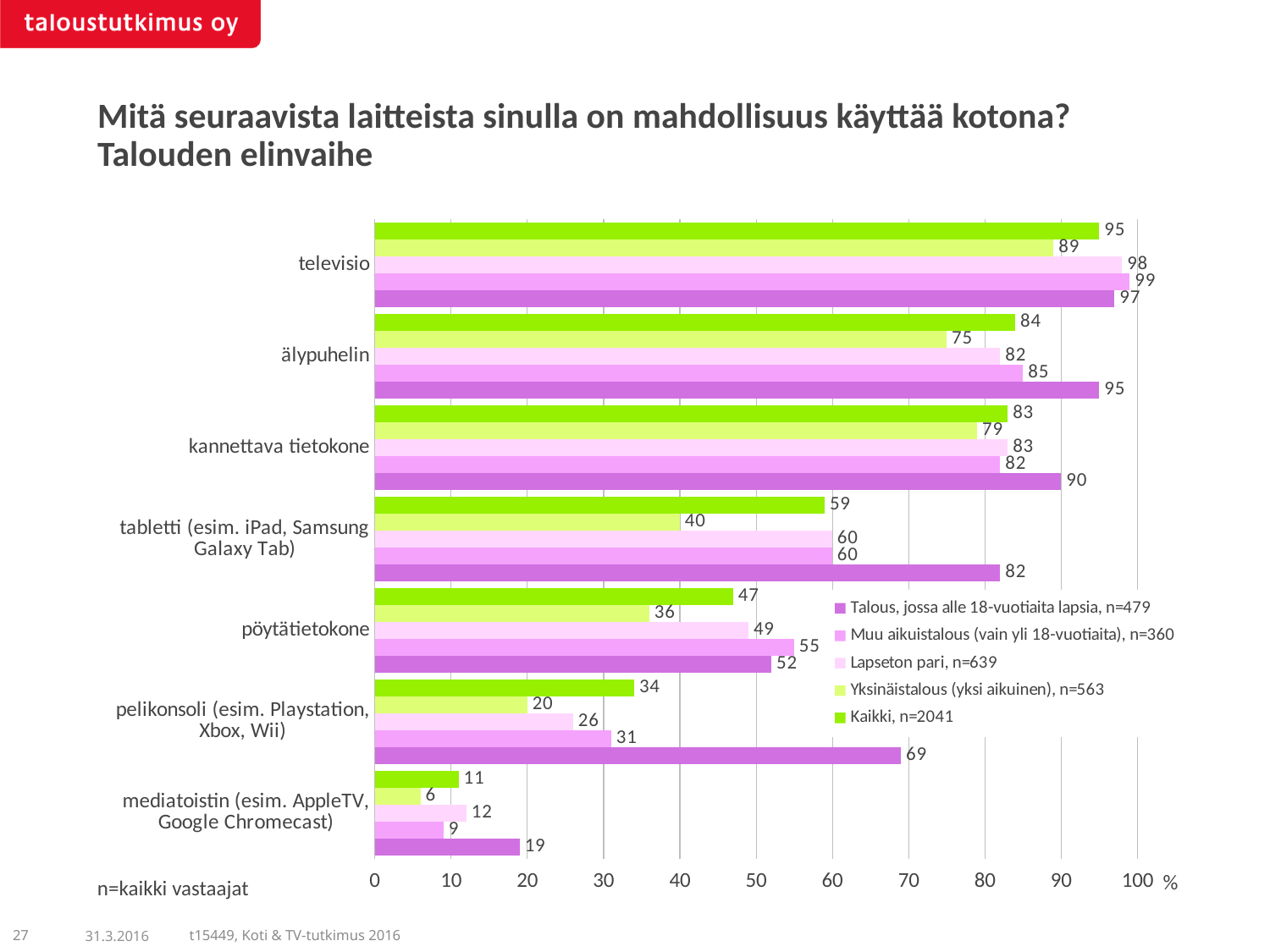
How many device categories are shown on the chart? 7 What kind of chart is shown on the slide? bar chart What is the value for 'Yksinäistalous (yksi aikuinen), n=563' for tabletti (esim. iPad, Samsung Galaxy Tab)? 40 What is the value for 'Muu aikuistalous (vain yli 18-vuotiaita), n=360' for älypuhelin? 85 What is the value for 'Lapseton pari, n=639' for mediatoistin (esim. AppleTV, Google Chromecast)? 12 What is the value for 'Kaikki, n=2041' for televisio? 95 Which series has the highest value for televisio? Muu aikuistalous (vain yli 18-vuotiaita), n=360 What is the difference between 'Talous, jossa alle 18-vuotiaita lapsia, n=479' and 'Yksinäistalous (yksi aikuinen), n=563' for pelikonsoli (esim. Playstation, Xbox, Wii)? 49 Which category has the lowest value for 'Kaikki, n=2041'? mediatoistin (esim. AppleTV, Google Chromecast) How many series does the legend list? 5 What is the value for 'Talous, jossa alle 18-vuotiaita lapsia, n=479' for pelikonsoli (esim. Playstation, Xbox, Wii)? 69 For pöytätietokone, which is larger: 'Muu aikuistalous (vain yli 18-vuotiaita), n=360' or 'Talous, jossa alle 18-vuotiaita lapsia, n=479'? Muu aikuistalous (vain yli 18-vuotiaita), n=360